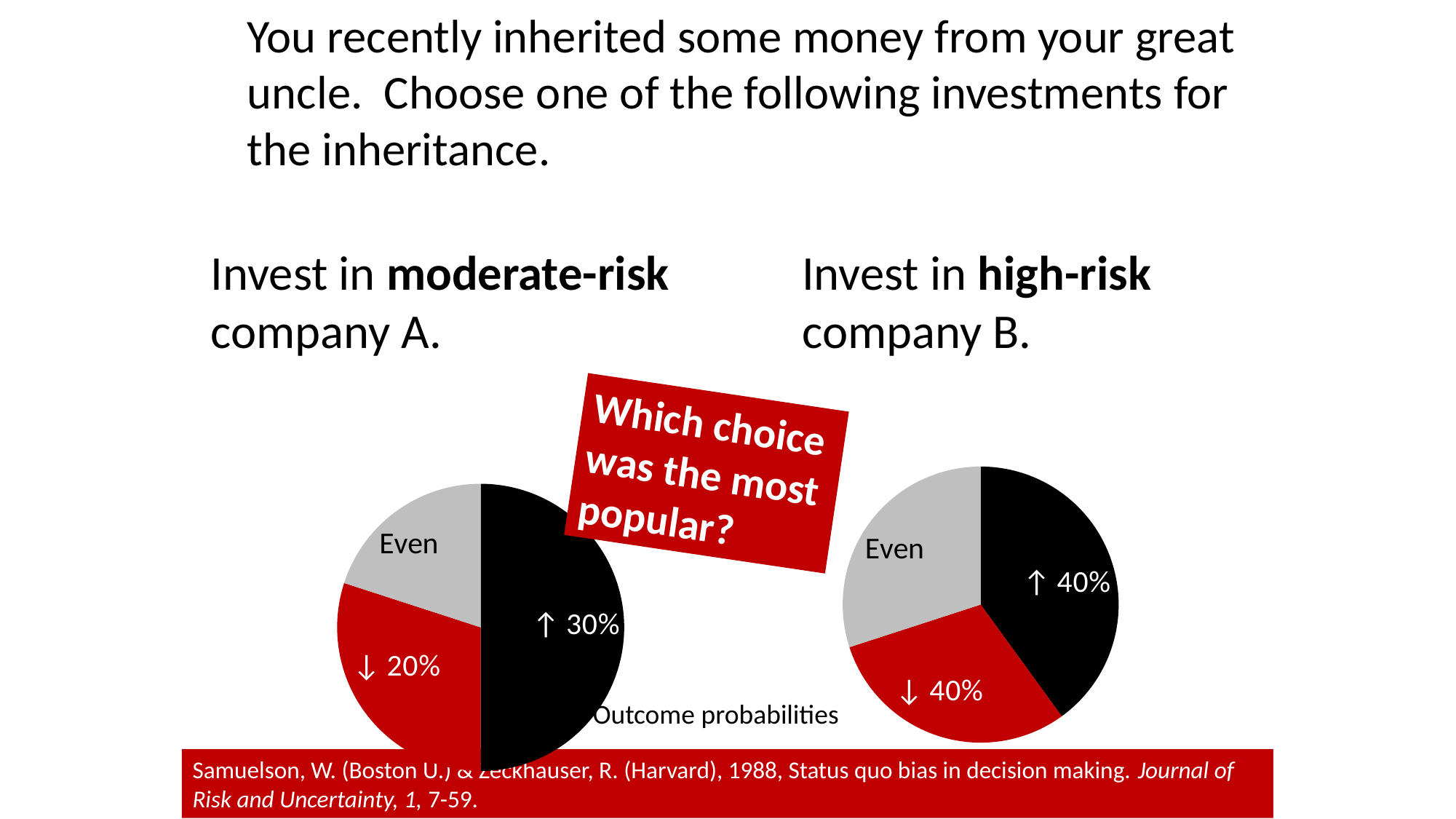
What colour is the 'Even' slice in both pie charts? Grey In the pie chart for company A (left), which is larger, the up (↑) probability or the down (↓) probability? Up (↑) How many slices does the pie chart for company A (left) have? 3 How many slices does the pie chart for company B (right) have? 3 What kind of charts are shown on the slide? Pie charts